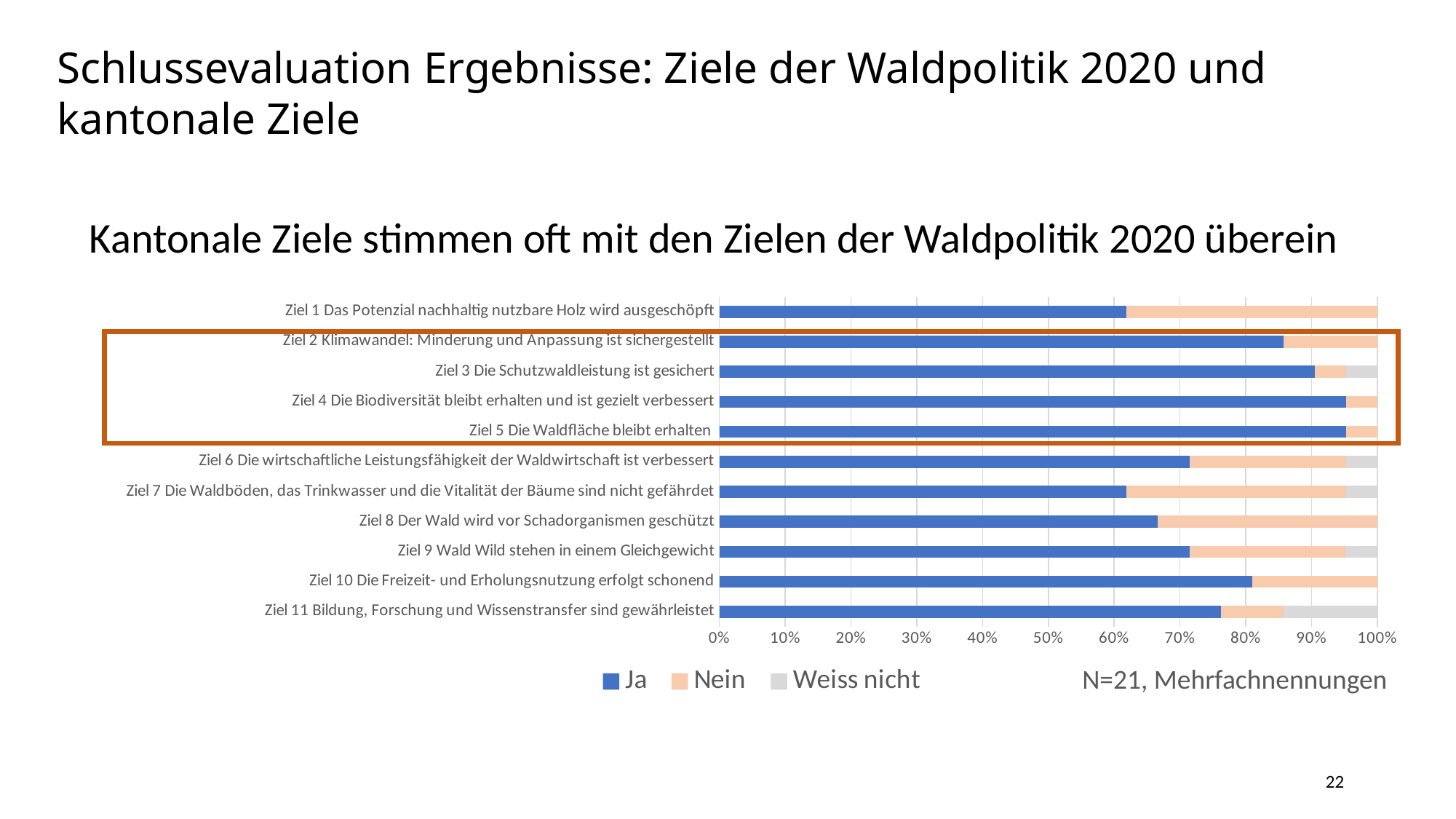
What are the three legend entries of the chart? Ja, Nein, Weiss nicht Which has a larger 'Ja' share, Ziel 2 or Ziel 1? Ziel 2 Is the 'Ja' share for Ziel 11 greater or less than 70%? greater Is the 'Ja' share for Ziel 8 greater or less than 70%? less How many goals (Ziele) are listed as categories in the chart? 11 How many series does the chart legend list? 3 Is the 'Ja' share for Ziel 1 greater or less than 70%? less What kind of chart is shown on the slide? Stacked bar chart Which has a larger 'Ja' share, Ziel 10 or Ziel 8? Ziel 10 What sample size is noted next to the chart legend? N=21, Mehrfachnennungen